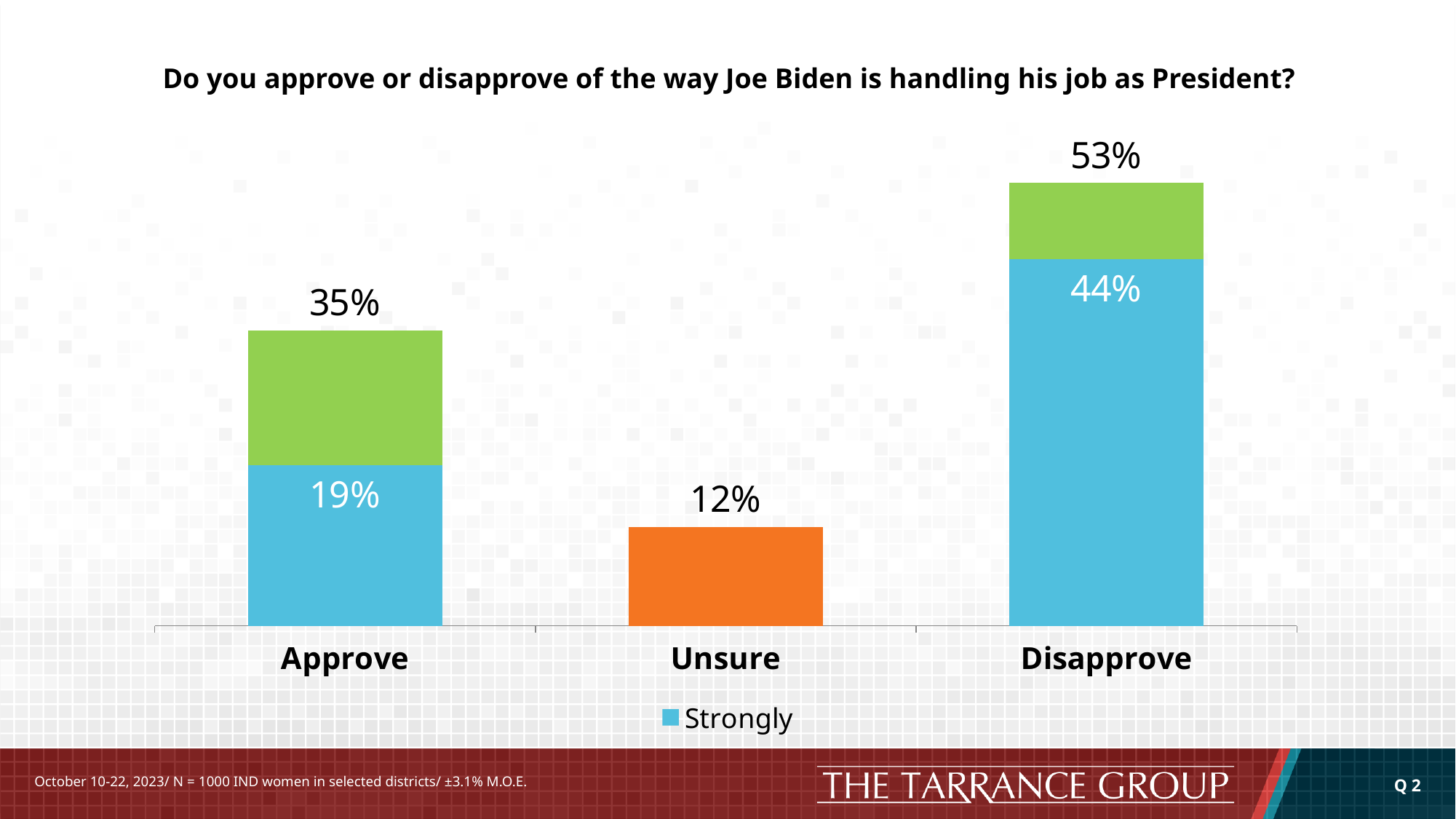
What is the Strongly value within the Disapprove bar? 44% What is the total value shown for Disapprove? 53% What is the difference between the Disapprove total and the Approve total? 18% What is the total value shown for Approve? 35% Which is larger, the Strongly value for Approve or the Strongly value for Disapprove? Disapprove What kind of chart is shown on the slide? Bar chart Which category has the lowest value? Unsure What entry does the legend list? Strongly What is the value shown for Unsure? 12% Which category has the highest total value? Disapprove How many categories are shown on the x axis? 3 What is the Strongly value within the Approve bar? 19%